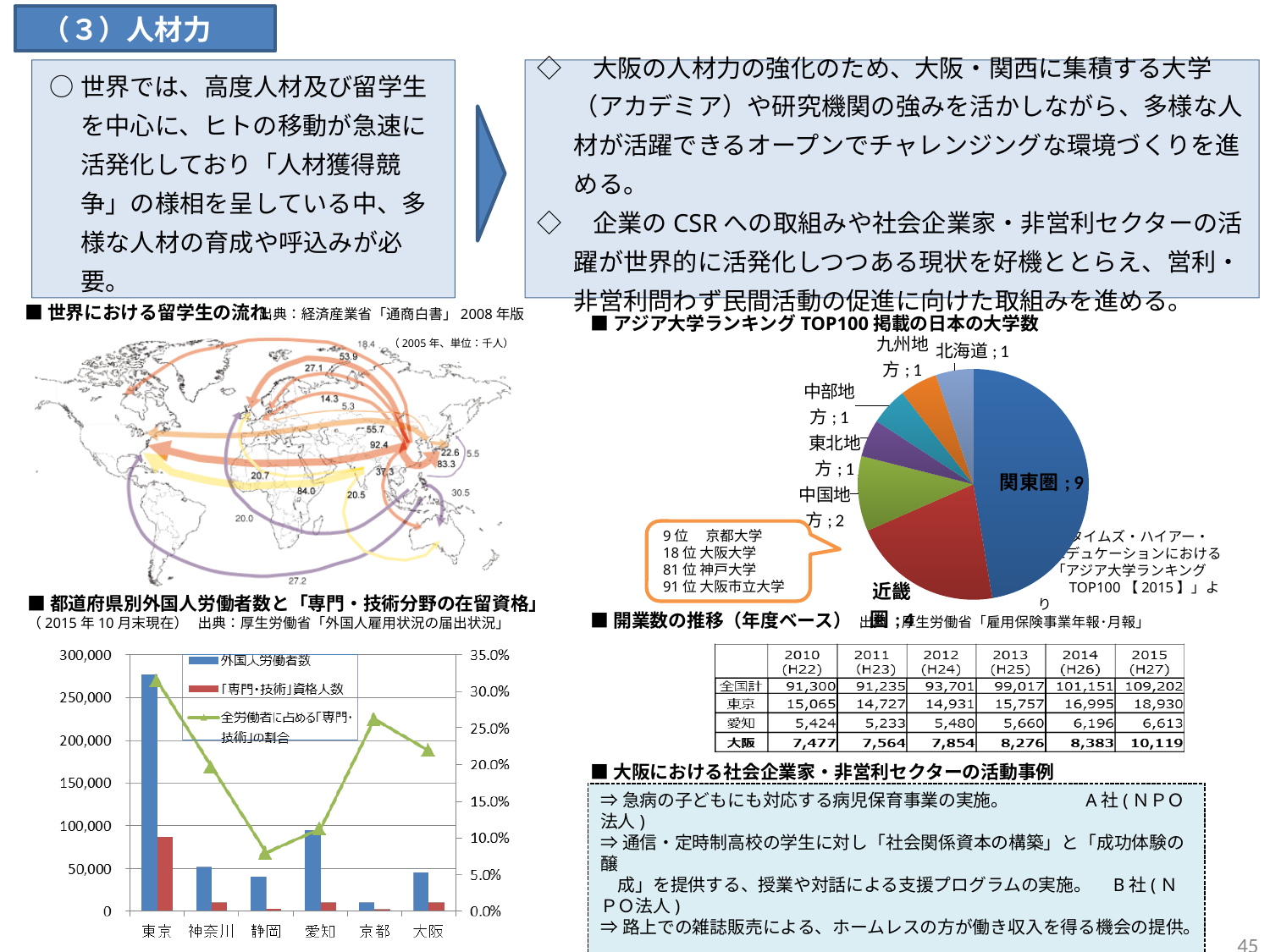
In the chart titled 都道府県別外国人労働者数と「専門・技術分野の在留資格」, which prefecture has the highest 外国人労働者数? 東京 In the pie chart titled アジア大学ランキングTOP100掲載の日本の大学数, what is the value for 中国地方? 2 In the chart titled 都道府県別外国人労働者数と「専門・技術分野の在留資格」, which prefecture has the lowest 全労働者に占める「専門・技術」の割合? 静岡 In the pie chart titled アジア大学ランキングTOP100掲載の日本の大学数, which region has the largest slice? 関東圏 In the pie chart titled アジア大学ランキングTOP100掲載の日本の大学数, what is the difference between the values for 関東圏 and 中国地方? 7 In the chart titled 都道府県別外国人労働者数と「専門・技術分野の在留資格」, how many series does the legend list? 3 In the chart titled 都道府県別外国人労働者数と「専門・技術分野の在留資格」, how many prefectures are shown on the x axis? 6 In the pie chart titled アジア大学ランキングTOP100掲載の日本の大学数, what is the value for 北海道? 1 In the pie chart titled アジア大学ランキングTOP100掲載の日本の大学数, what is the value for 関東圏? 9 What kind of chart is the one titled アジア大学ランキングTOP100掲載の日本の大学数? pie chart In the chart titled 都道府県別外国人労働者数と「専門・技術分野の在留資格」, is the 外国人労働者数 for 東京 greater or less than 250,000? greater